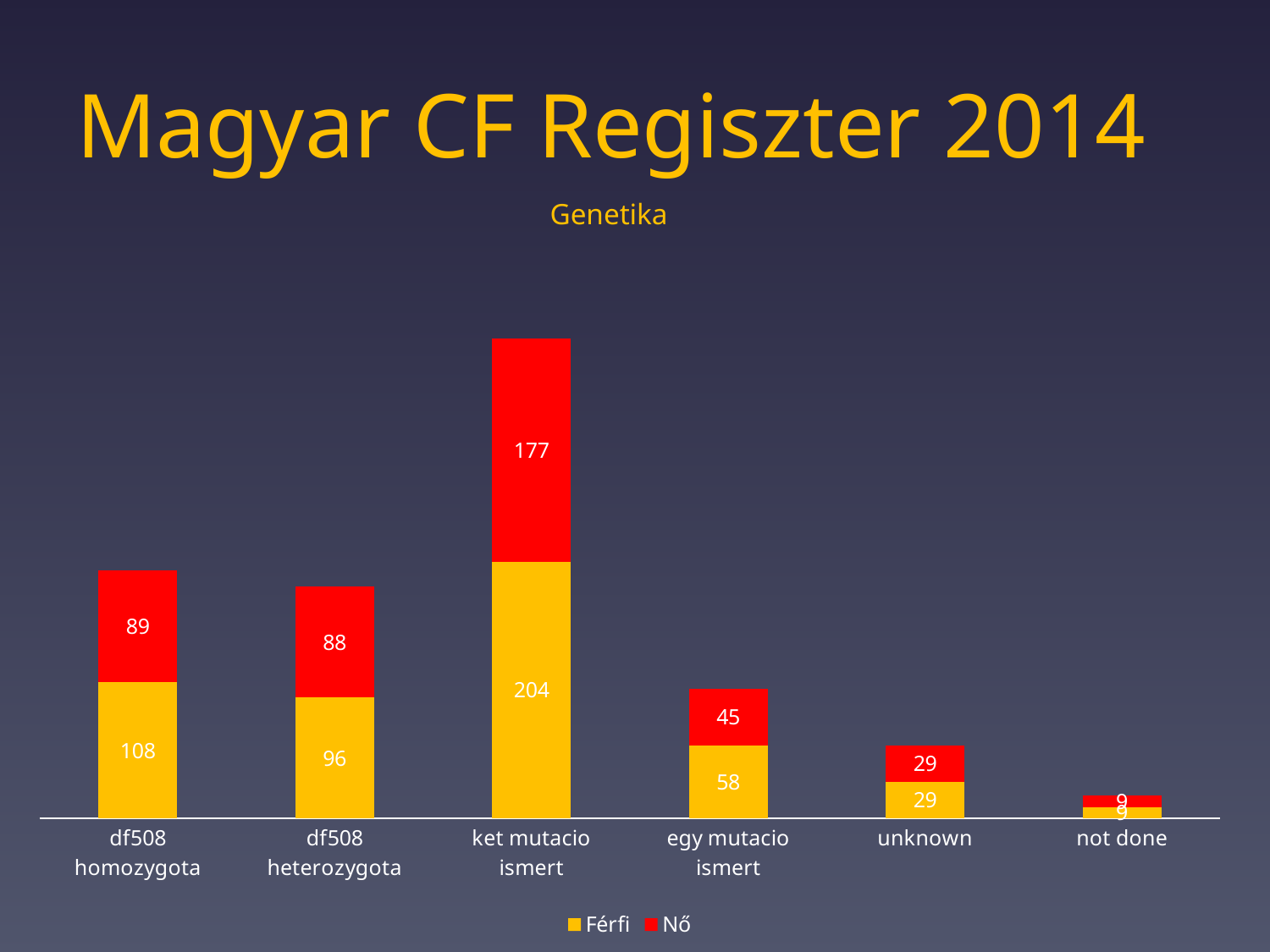
Which category has the highest Férfi value? ket mutacio ismert What is the Férfi value for egy mutacio ismert? 58 What is the total of the stacked bar for unknown? 58 What is the difference between the Férfi and Nő values for df508 homozygota? 19 What is the Férfi value for ket mutacio ismert? 204 Which category has the lowest Nő value? not done How many categories are shown on the x axis? 6 Which is larger, the Nő value for egy mutacio ismert or the Nő value for unknown? egy mutacio ismert What is the Nő value for df508 homozygota? 89 What is the total of the stacked bar for ket mutacio ismert? 381 How many series does the legend list? 2 What is the Nő value for df508 heterozygota? 88